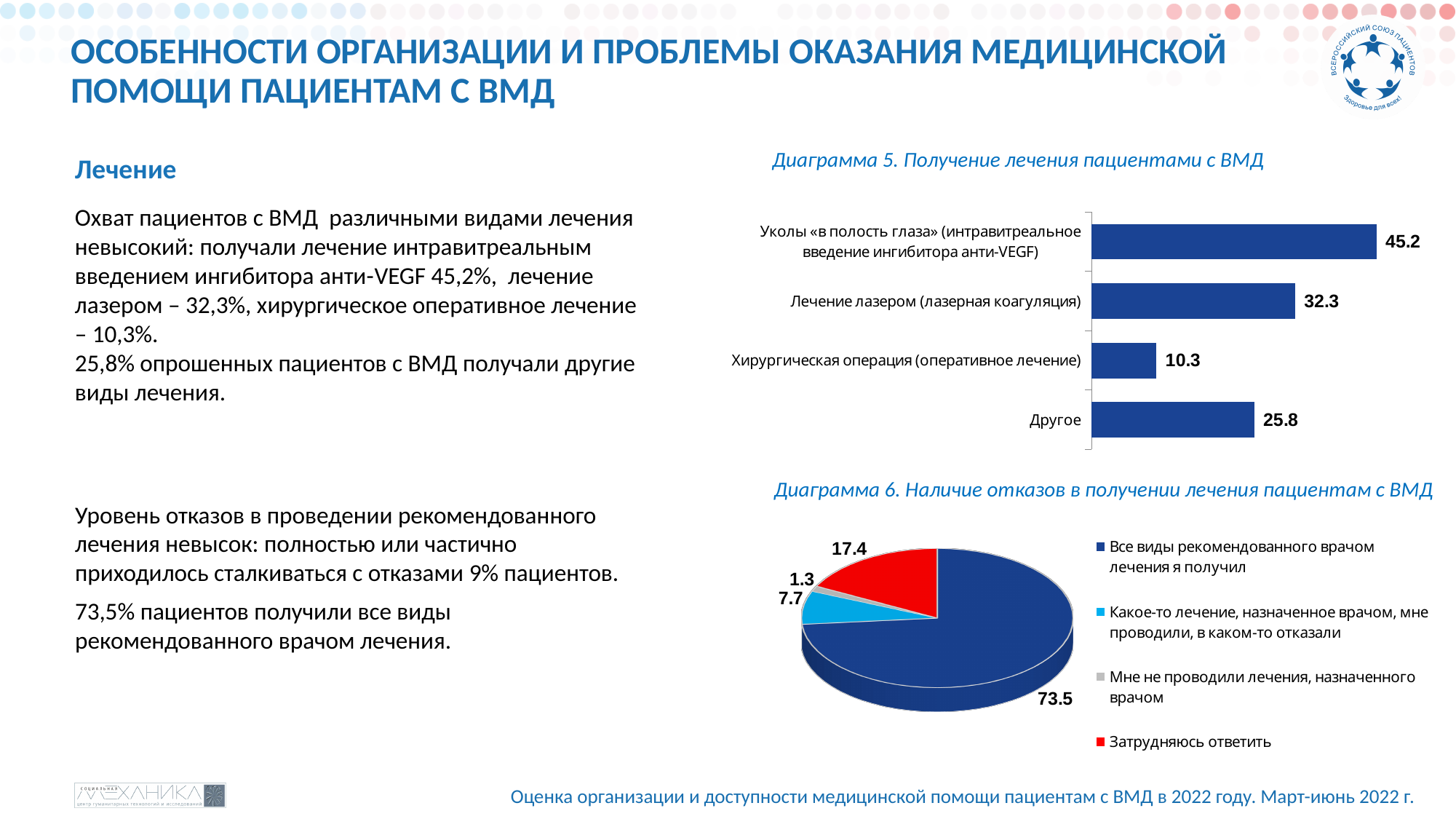
In Диаграмма 5, which category has the lowest value? Хирургическая операция (оперативное лечение) In Диаграмма 5, which category has the highest value? Уколы «в полость глаза» (интравитреальное введение ингибитора анти-VEGF) In Диаграмма 5, what is the difference between the values for «Уколы «в полость глаза»» and «Лечение лазером»? 12.9 In Диаграмма 5, what is the value for «Лечение лазером (лазерная коагуляция)»? 32.3 In Диаграмма 5, what is the value for «Другое»? 25.8 How many entries does the legend of Диаграмма 6 list? 4 In Диаграмма 6, what is the value for «Затрудняюсь ответить»? 17.4 In Диаграмма 5, which is larger: the value for «Другое» or for «Хирургическая операция»? Другое What type of chart is Диаграмма 5? Bar chart In Диаграмма 6, which slice is the smallest? Мне не проводили лечения, назначенного врачом In Диаграмма 6, which slice is the largest? Все виды рекомендованного врачом лечения я получил How many categories are shown in Диаграмма 5? 4